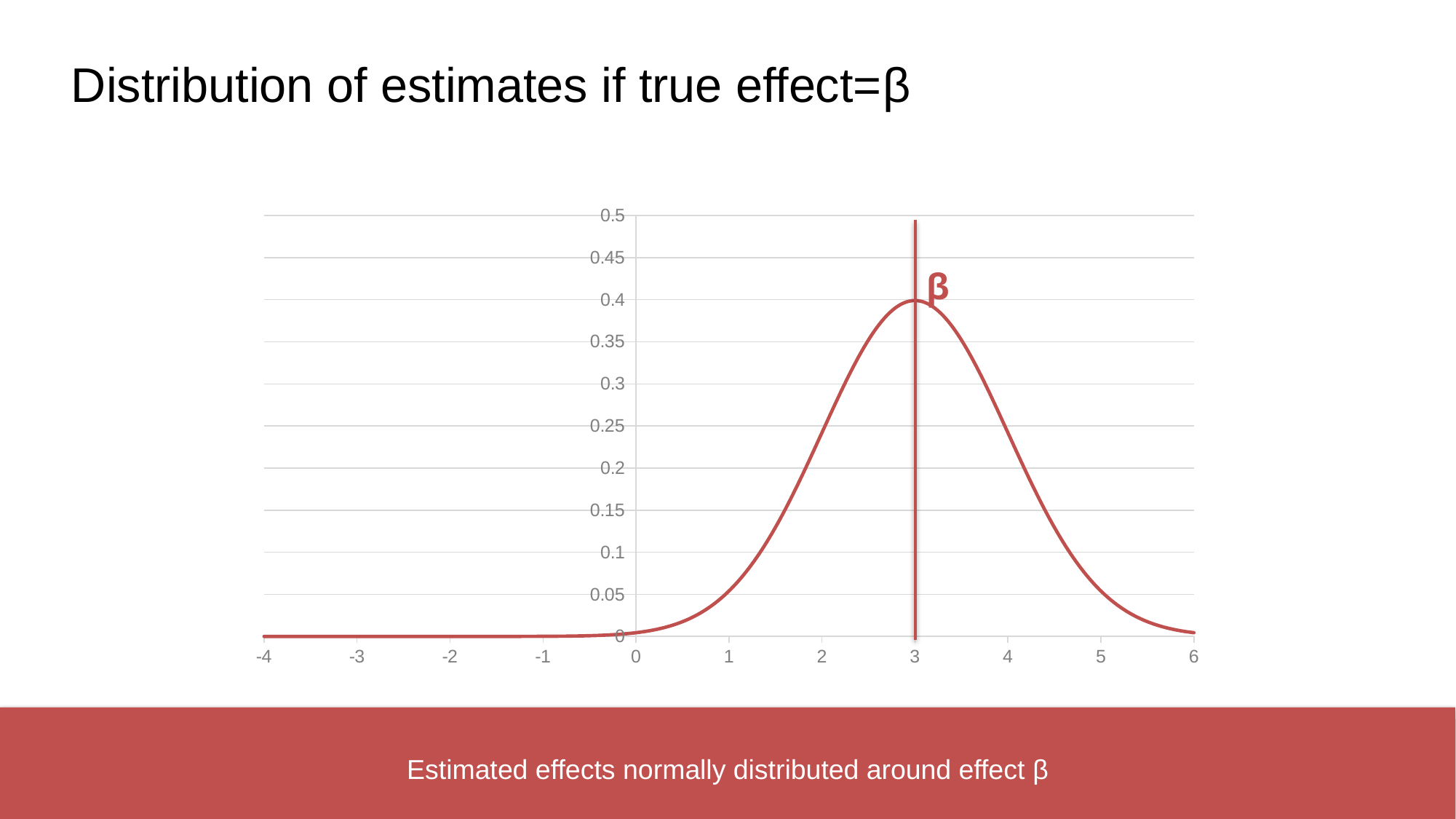
Is the value of the curve at x = 2 greater or less than 0.2? greater Does the curve rise or fall as x goes from 3 to 6? fall At which x-axis value does the curve reach its highest point? 3 Is the value of the curve at x = 3 greater or less than 0.35? greater At which x-axis value does the vertical line labelled β sit? 3 What kind of chart is shown on the slide? line chart Is the value of the curve at x = 4 greater or less than 0.3? less What is the title of the slide containing the chart? Distribution of estimates if true effect=β What is the highest value labelled on the y axis? 0.5 How many labelled tick marks are on the x axis? 11 Which is larger, the value of the curve at x = 2 or at x = 0? x = 2